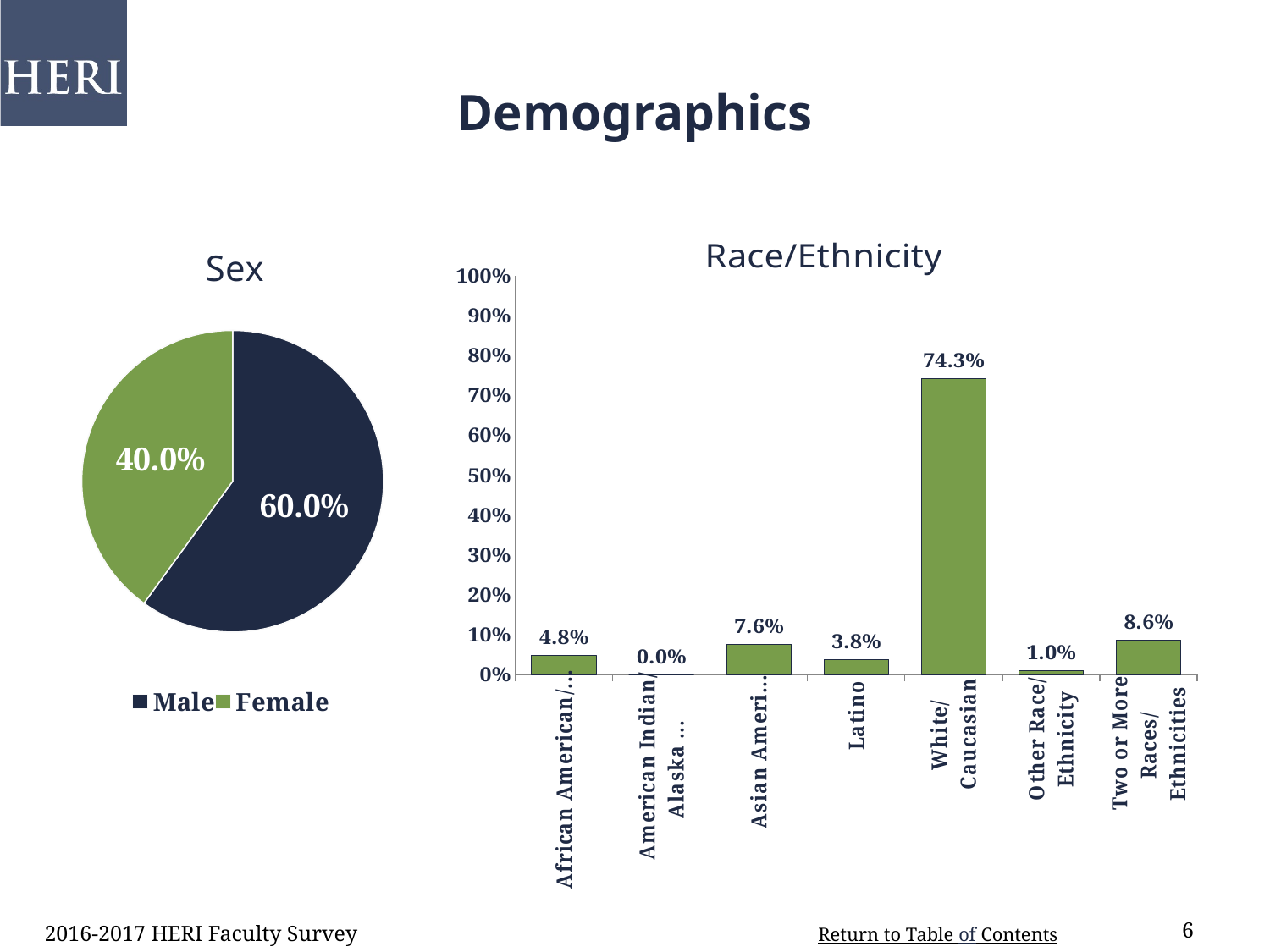
In the Sex pie chart, which category has the larger share, Male or Female? Male In the Race/Ethnicity chart, which category has the highest value? White/Caucasian In the Race/Ethnicity chart, what is the difference between White/Caucasian and Two or More Races/Ethnicities? 65.7% What kind of chart is the Race/Ethnicity chart? Bar chart In the Race/Ethnicity chart, what is the value for Two or More Races/Ethnicities? 8.6% In the Sex pie chart, what percentage is Male? 60.0% In the Sex pie chart, what percentage is Female? 40.0% What kind of chart is the Sex chart? Pie chart In the Race/Ethnicity chart, what is the value for White/Caucasian? 74.3% In the Race/Ethnicity chart, what is the value for Latino? 3.8% How many categories are shown in the Race/Ethnicity chart? 7 In the Race/Ethnicity chart, which category has the lowest value? American Indian/Alaska